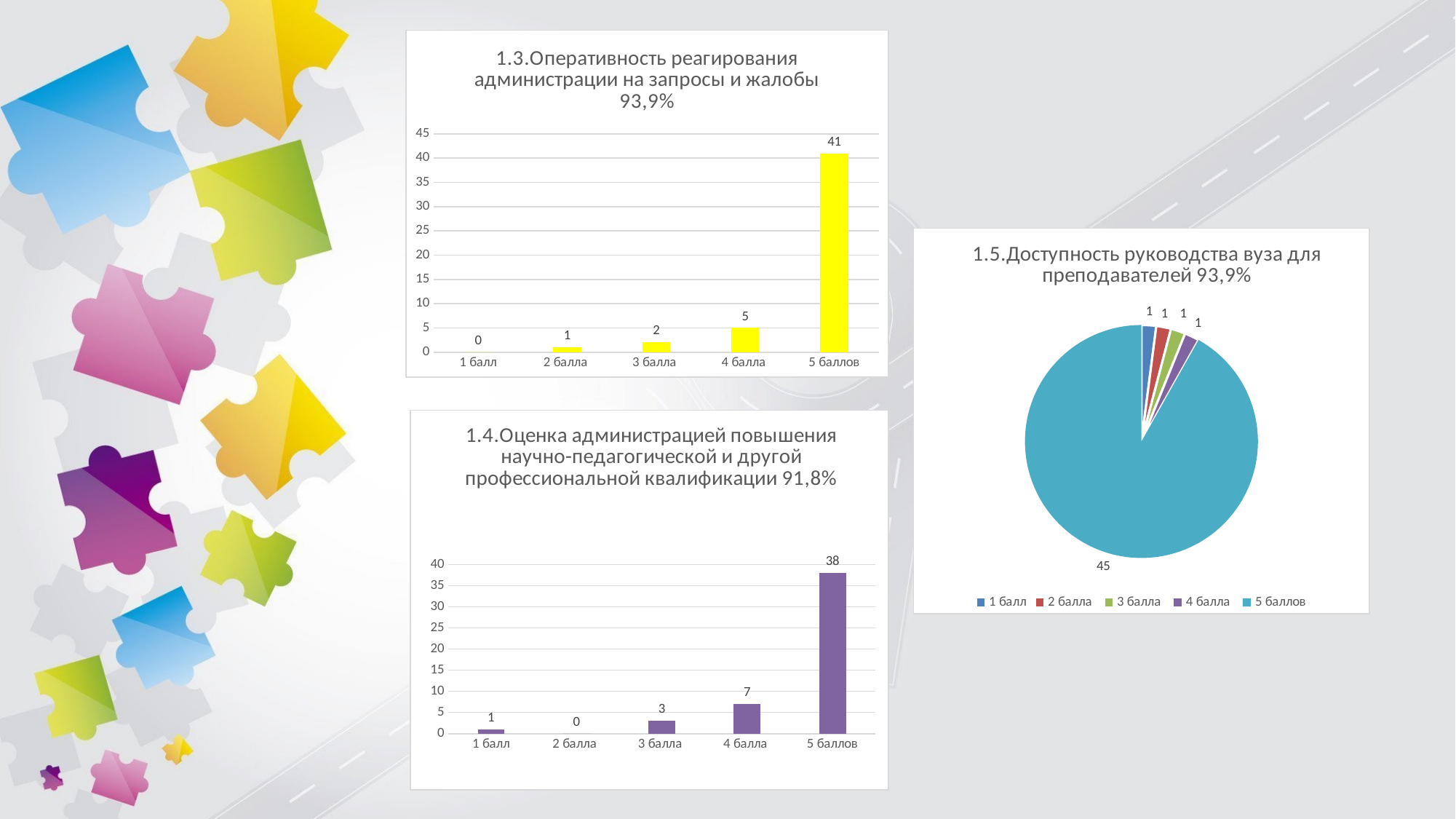
In the chart '1.4.Оценка администрацией повышения научно-педагогической и другой профессиональной квалификации 91,8%', which is larger, the value for 3 балла or 4 балла? 4 балла How many entries does the legend of the chart '1.5.Доступность руководства вуза для преподавателей 93,9%' list? 5 In the chart '1.3.Оперативность реагирования администрации на запросы и жалобы 93,9%', what is the value for 5 баллов? 41 In the chart '1.3.Оперативность реагирования администрации на запросы и жалобы 93,9%', how many categories are shown on the x axis? 5 In the chart '1.5.Доступность руководства вуза для преподавателей 93,9%', what is the value for 5 баллов? 45 In the chart '1.4.Оценка администрацией повышения научно-педагогической и другой профессиональной квалификации 91,8%', which category has the lowest value? 2 балла In the chart '1.3.Оперативность реагирования администрации на запросы и жалобы 93,9%', which category has the lowest value? 1 балл What kind of chart is '1.5.Доступность руководства вуза для преподавателей 93,9%'? pie chart In the chart '1.3.Оперативность реагирования администрации на запросы и жалобы 93,9%', what is the difference between the values for 5 баллов and 4 балла? 36 In the chart '1.3.Оперативность реагирования администрации на запросы и жалобы 93,9%', what is the value for 4 балла? 5 In the chart '1.4.Оценка администрацией повышения научно-педагогической и другой профессиональной квалификации 91,8%', what is the value for 5 баллов? 38 What kind of chart is '1.4.Оценка администрацией повышения научно-педагогической и другой профессиональной квалификации 91,8%'? bar chart